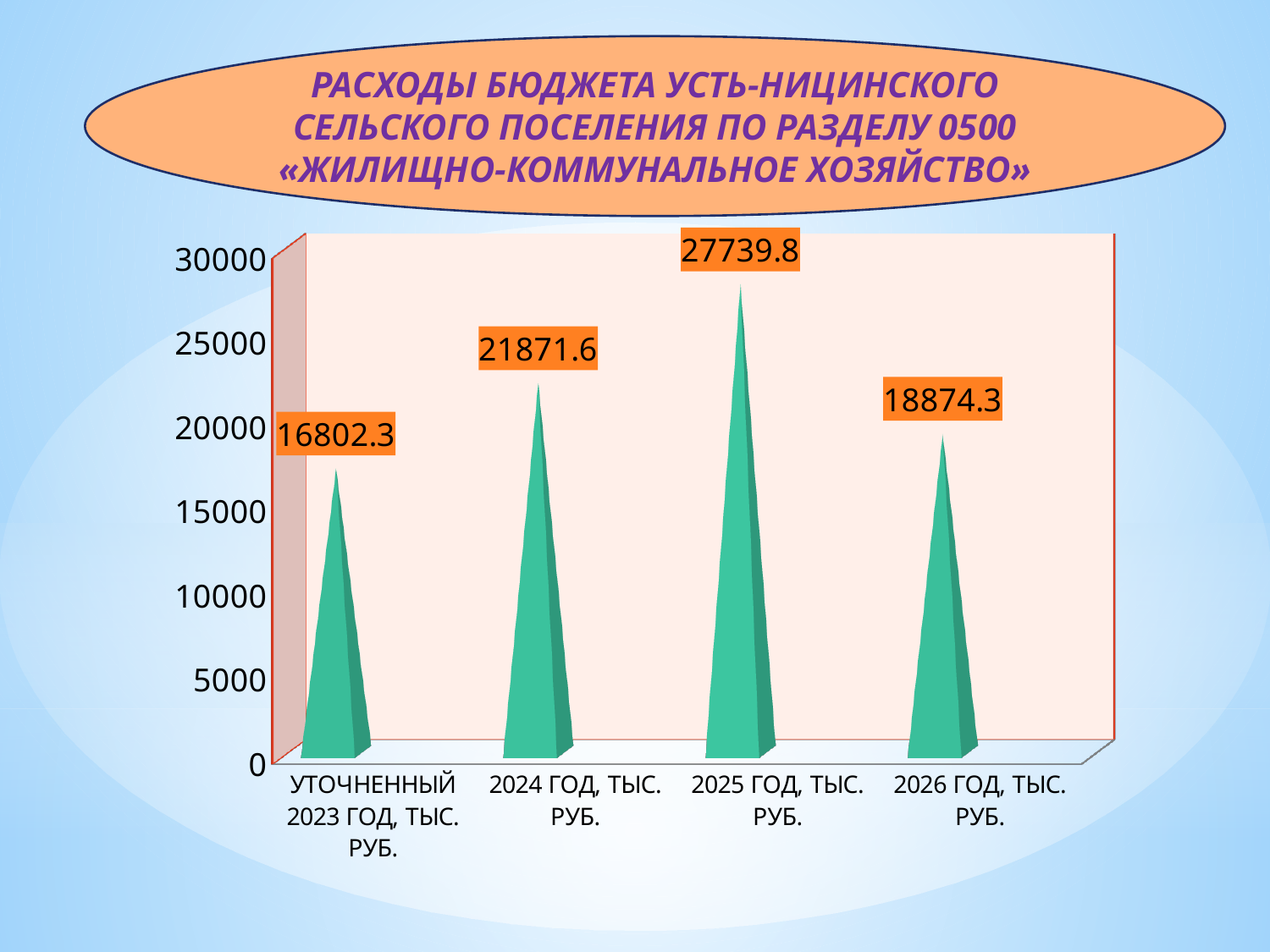
Which year has the highest value? 2025 год, тыс. руб. Which year has the lowest value? Уточненный 2023 год, тыс. руб. What is the value for Уточненный 2023 год, тыс. руб.? 16802.3 What kind of chart is shown on the slide? bar chart What is the difference between the values for 2025 год and 2024 год? 5868.2 What is the difference between the values for 2026 год and Уточненный 2023 год? 2072.0 Do the values rise or fall from Уточненный 2023 год to 2025 год? rise What is the value for 2026 год, тыс. руб.? 18874.3 Is the value for 2025 год greater or less than 25000? greater Which is larger, the value for 2024 год or the value for 2026 год? 2024 год, тыс. руб. What is the value for 2024 год, тыс. руб.? 21871.6 How many categories are shown on the x axis? 4